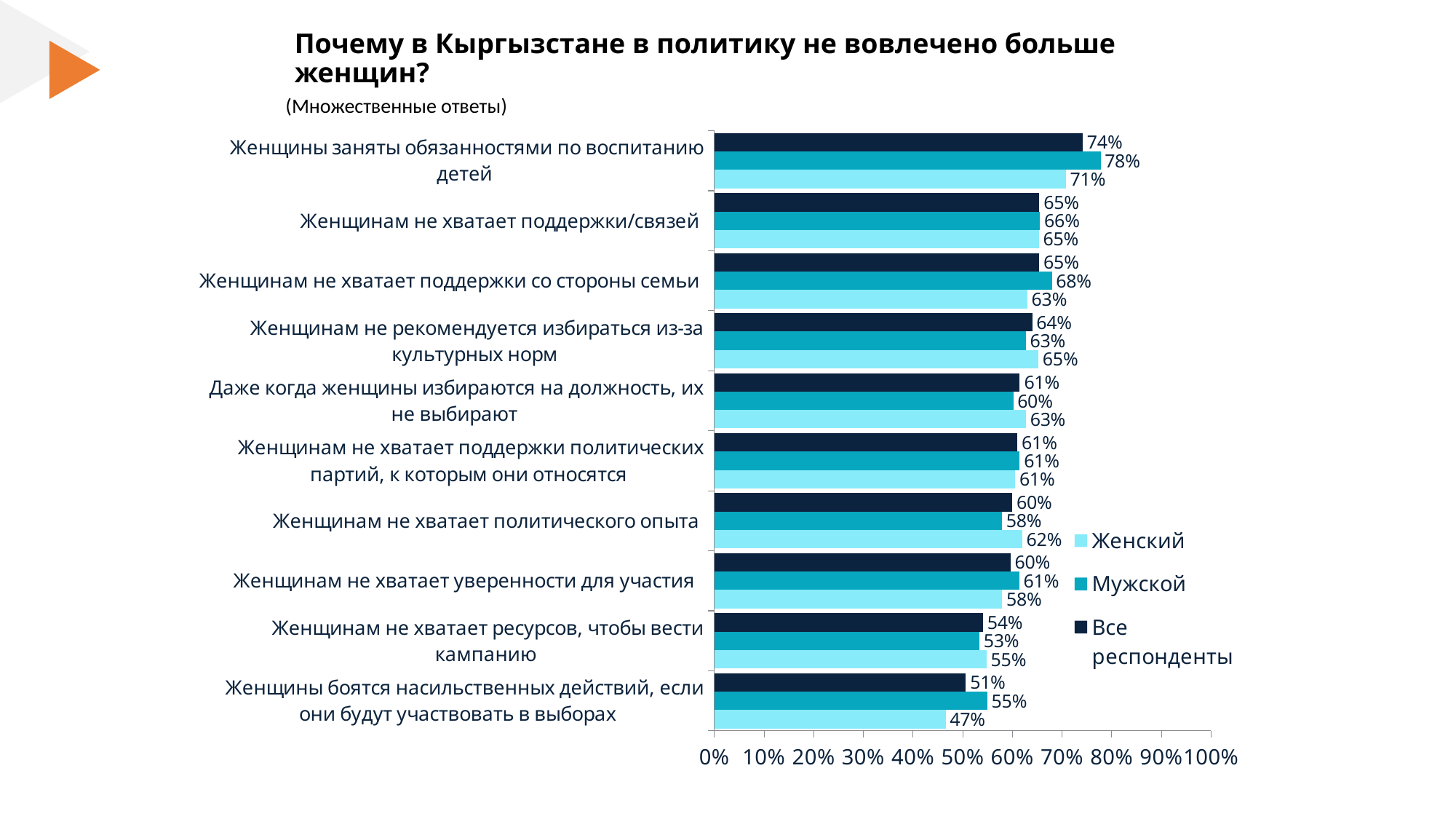
What is the value for "Женский" for "Женщины боятся насильственных действий, если они будут участвовать в выборах"? 47% How many series does the legend list? 3 What is the difference between the "Мужской" and "Женский" values for "Женщины заняты обязанностями по воспитанию детей"? 7% How many categories (reasons) are shown on the chart? 10 For "Женщины боятся насильственных действий, если они будут участвовать в выборах", which is larger: the "Мужской" value or the "Женский" value? Мужской What is the value for "Все респонденты" for "Женщины заняты обязанностями по воспитанию детей"? 74% Which category has the highest value for the "Мужской" series? Женщины заняты обязанностями по воспитанию детей Is the "Все респонденты" value for "Женщинам не хватает ресурсов, чтобы вести кампанию" greater or less than 60%? less What is the value for "Мужской" for "Женщинам не хватает поддержки со стороны семьи"? 68% Which category has the lowest value for the "Женский" series? Женщины боятся насильственных действий, если они будут участвовать в выборах What is the title of the chart? Почему в Кыргызстане в политику не вовлечено больше женщин? What kind of chart is shown on the slide? bar chart